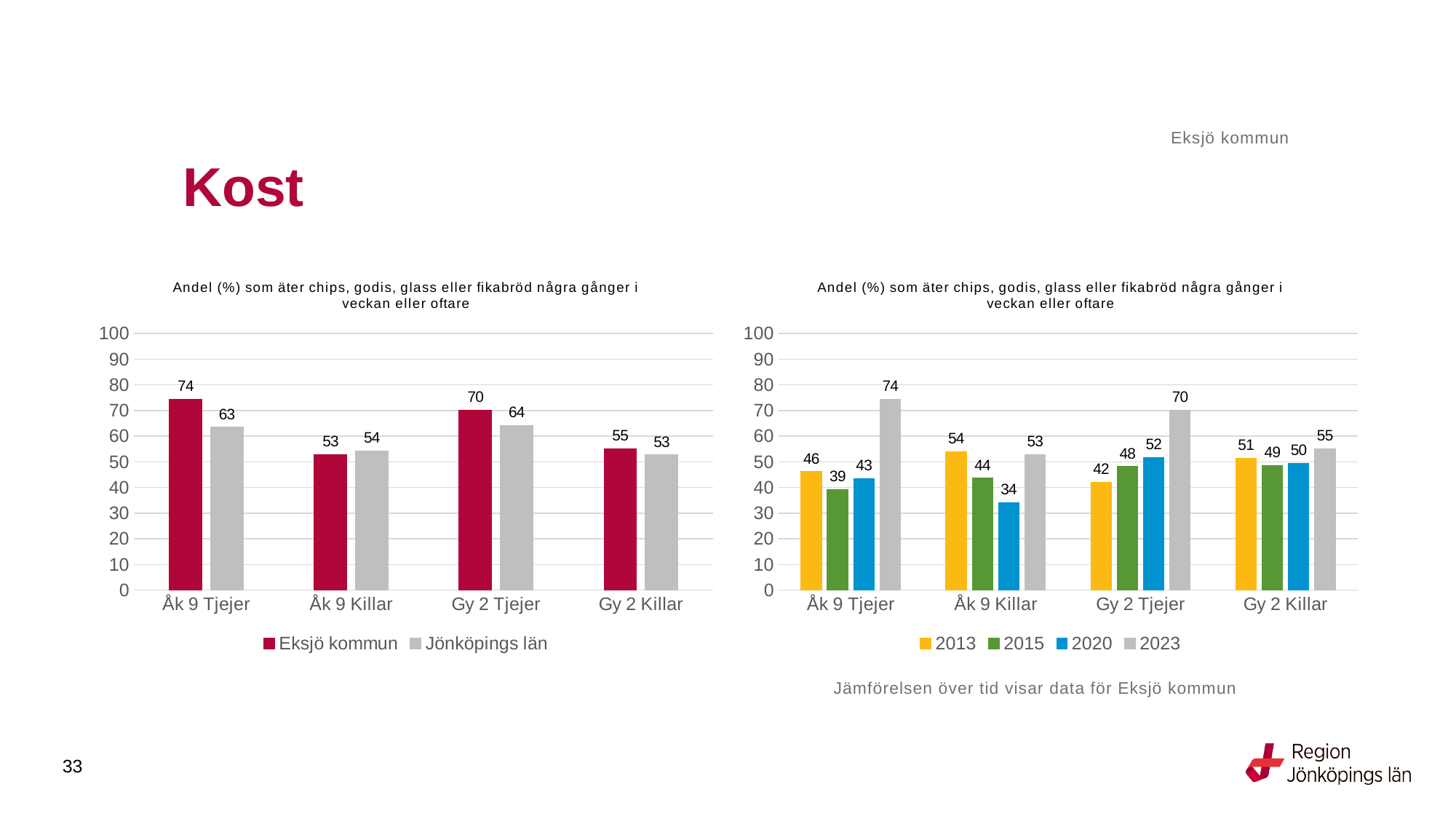
In the right chart, what is the difference between 2023 and 2015 for Åk 9 Tjejer? 35 In the left chart, what is the value for Jönköpings län for Gy 2 Tjejer? 64 In the right chart, what is the value for 2013 for Gy 2 Tjejer? 42 What kind of chart is the right chart? Bar chart In the left chart, what is the difference between Eksjö kommun and Jönköpings län for Åk 9 Tjejer? 11 In the left chart, what is the value for Eksjö kommun for Åk 9 Tjejer? 74 How many series does the legend of the right chart list? 4 In the left chart, which category has the lowest value for Eksjö kommun? Åk 9 Killar How many series does the legend of the left chart list? 2 In the right chart, which year has the highest value for Åk 9 Tjejer? 2023 In the right chart, what is the value for 2020 for Åk 9 Killar? 34 In the left chart, which is larger for Gy 2 Killar: Eksjö kommun or Jönköpings län? Eksjö kommun